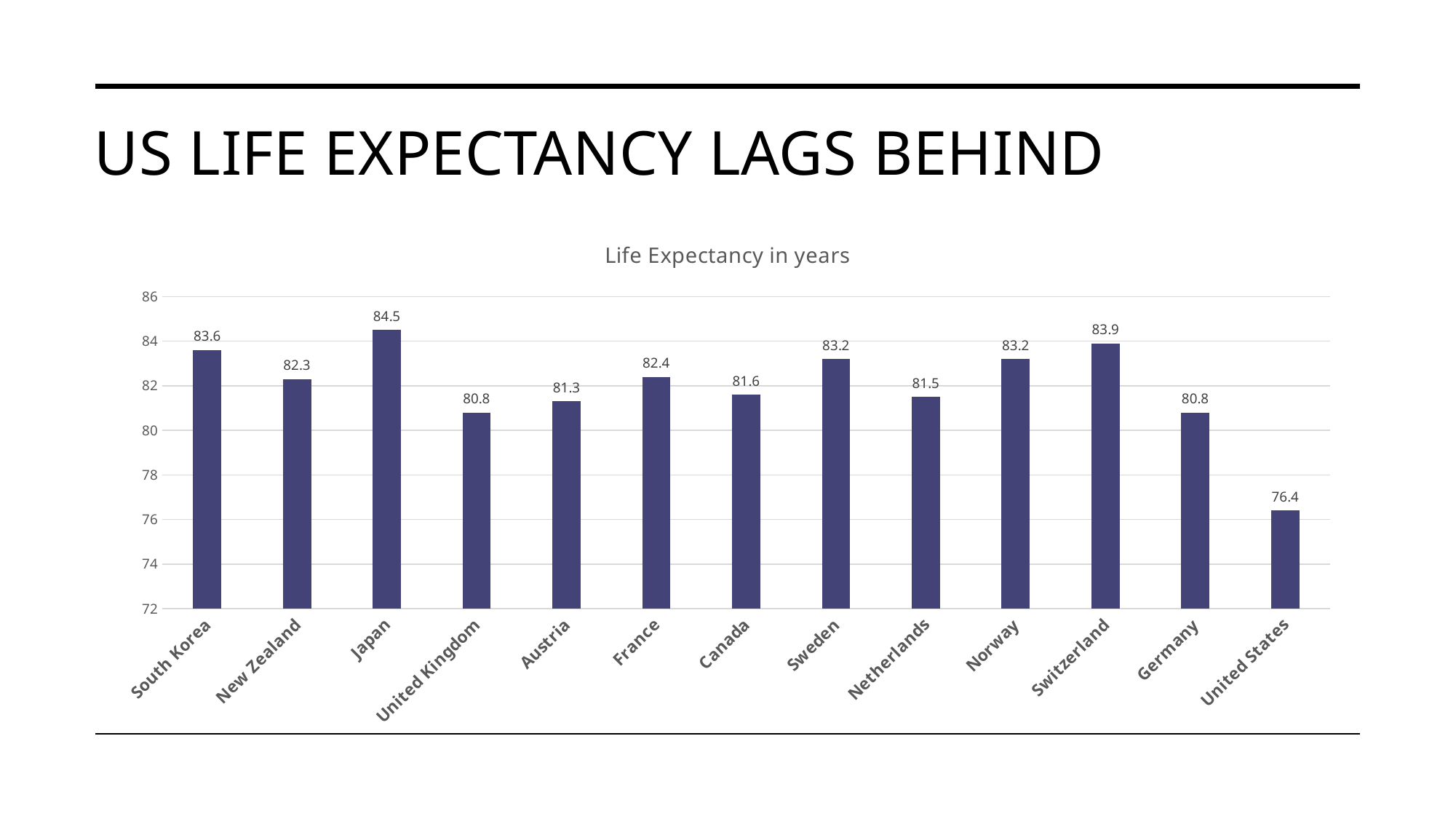
How many countries are shown on the chart? 13 What kind of chart is shown on the slide? Bar chart What is the difference in life expectancy between South Korea and New Zealand? 1.3 Is the value for the United States greater or less than 78? less Which country has the highest life expectancy on the chart? Japan What is the life expectancy shown for the United States? 76.4 Which has a higher life expectancy, France or Canada? France What is the difference in life expectancy between Japan and the United States? 8.1 Which country has the lowest life expectancy on the chart? United States What is the life expectancy shown for Switzerland? 83.9 What is the title of the chart? Life Expectancy in years What is the life expectancy shown for Japan? 84.5